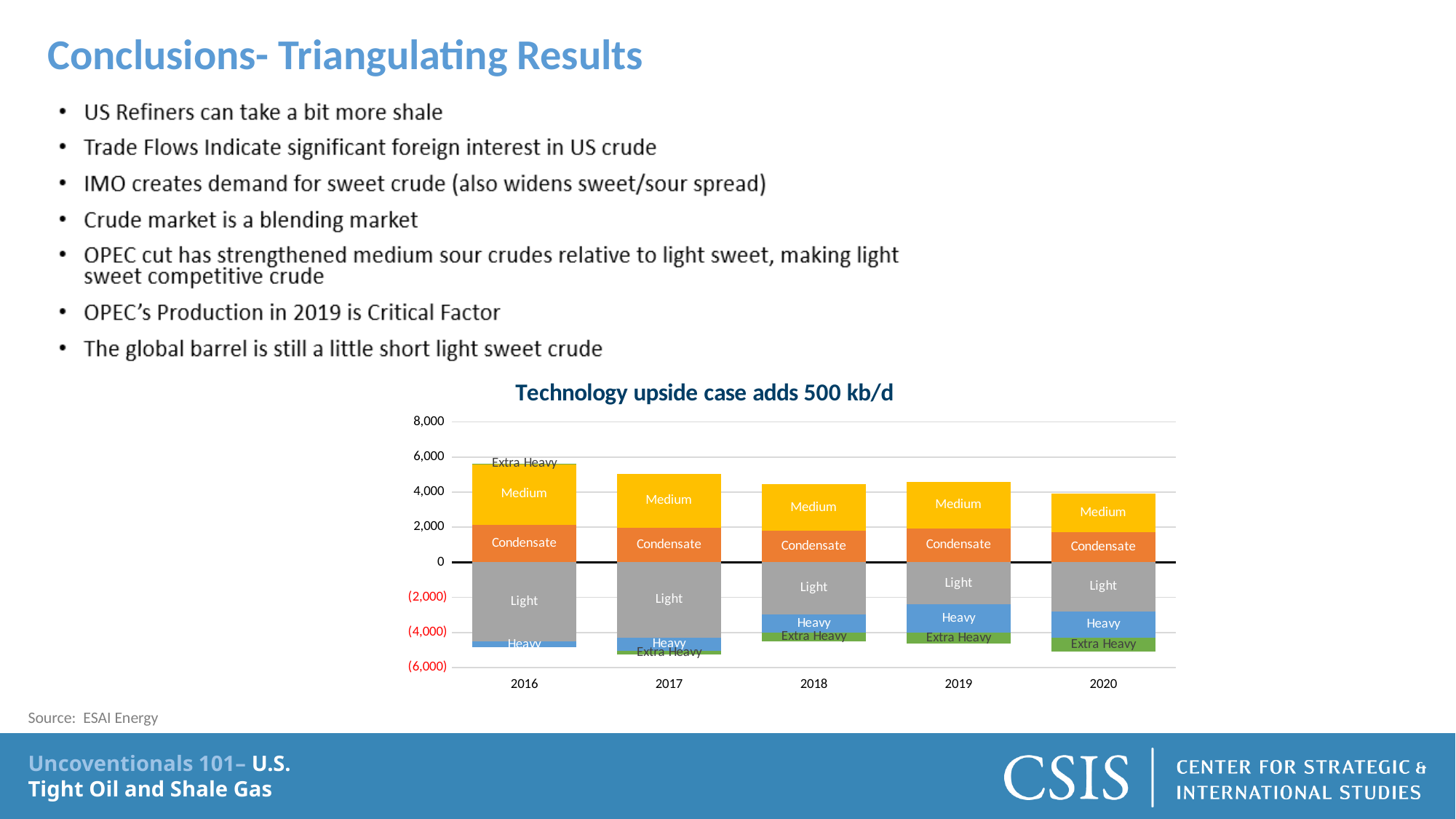
What kind of chart is shown on the slide? Stacked bar chart Which year has the tallest stack above zero in the chart? 2016 Does the positive stack generally rise or fall from 2016 to 2020? fall Is the top of the positive stack for 2020 greater or less than 6,000? less Which year has a larger positive stack, 2016 or 2020? 2016 Which crude category is shown in yellow in the chart? Medium Which year has the shortest stack above zero in the chart? 2020 Which segment is the largest in the 2016 bar? Light How many years are shown on the x axis of the chart? 5 Is the top of the positive stack for 2016 greater or less than 4,000? greater What is the title of the chart? Technology upside case adds 500 kb/d Is the bottom of the negative stack for 2016 above or below (4,000)? below